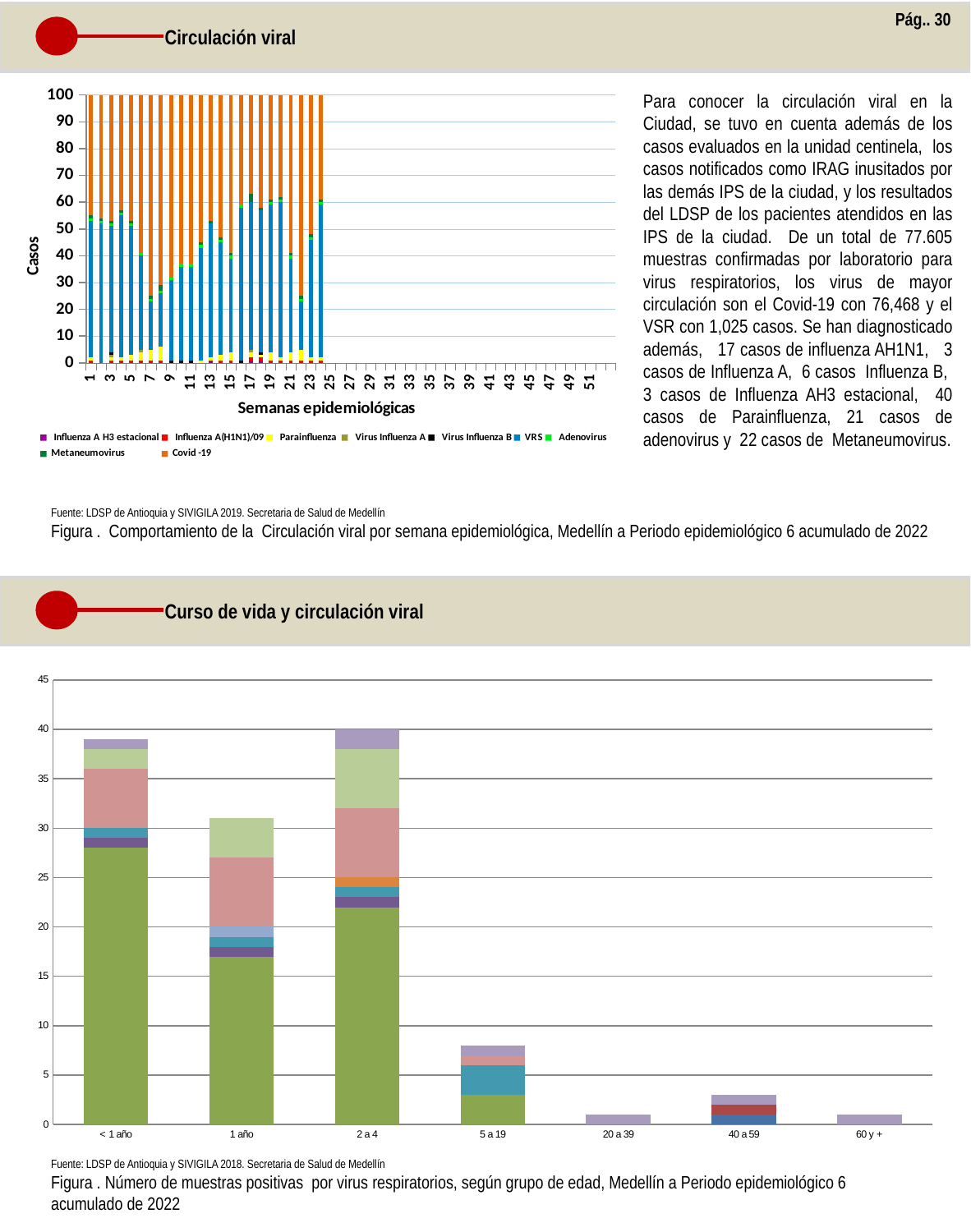
What kind of chart is the top chart (Circulación viral by semana epidemiológica)? bar chart In the bottom chart, is the total for '< 1 año' greater or less than 35? greater How many series does the legend of the top chart list? 9 Which series is listed last in the legend of the top chart? Covid -19 In the bottom chart, is the total for '40 a 59' greater or less than 5? less In the bottom chart, is the total for '5 a 19' greater or less than 10? less What kind of chart is the bottom chart (muestras positivas por grupo de edad)? bar chart How many age-group categories are shown on the x axis of the bottom chart? 7 In the bottom chart, which has the larger total bar: '2 a 4' or '40 a 59'? 2 a 4 What is the x-axis title of the top chart? Semanas epidemiológicas In the bottom chart, which has the larger total bar: '1 año' or '5 a 19'? 1 año